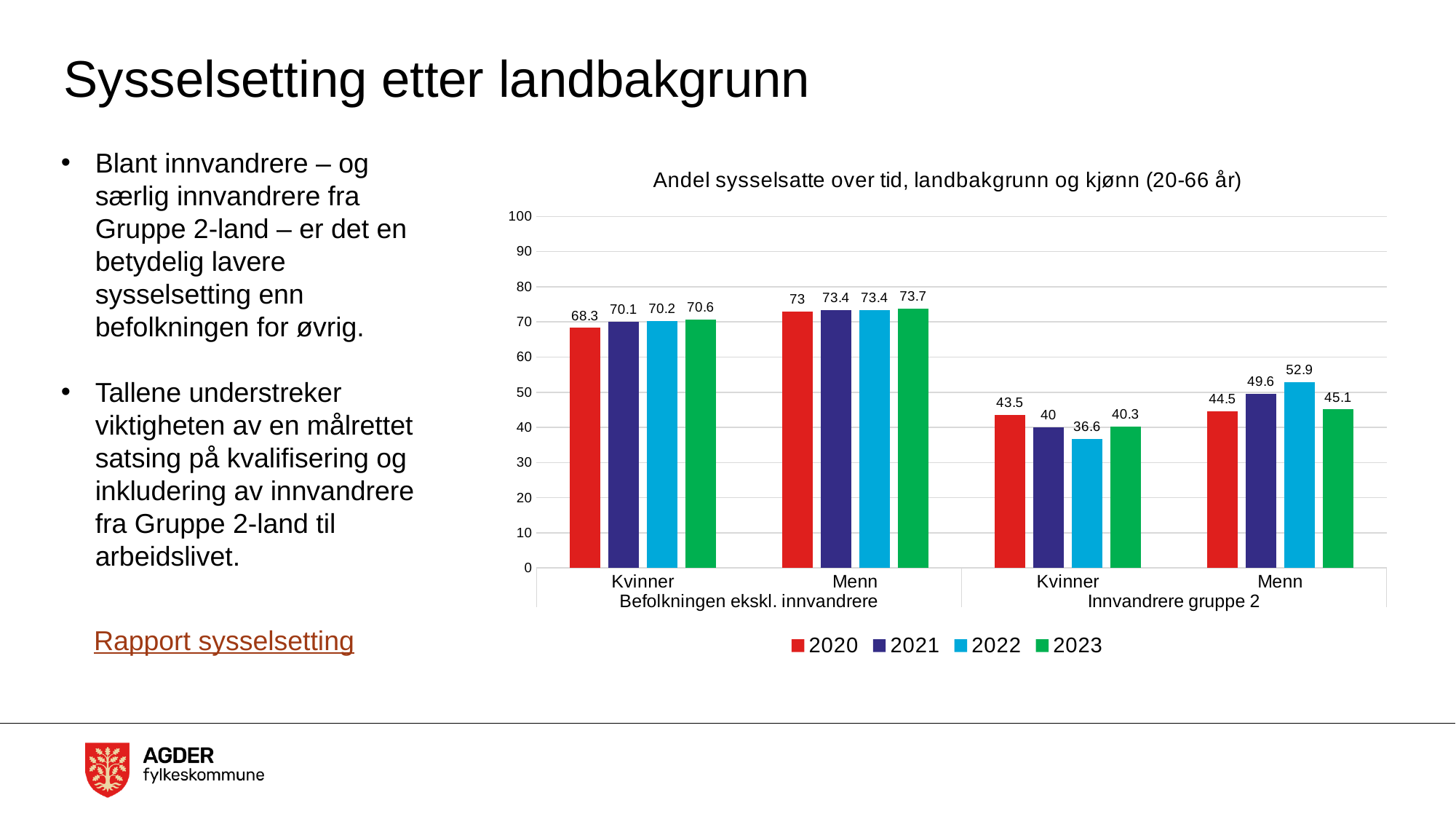
What is the value for Menn in Befolkningen ekskl. innvandrere for 2023? 73.7 What is the value for Kvinner in Innvandrere gruppe 2 for 2021? 40 Which year has the highest value for Menn in Innvandrere gruppe 2? 2022 What is the value for Kvinner in Befolkningen ekskl. innvandrere for 2020? 68.3 How many series does the legend list? 4 What kind of chart is shown on the slide? Bar chart What is the value for Menn in Innvandrere gruppe 2 for 2022? 52.9 What is the difference between the 2023 values for Menn in Befolkningen ekskl. innvandrere and Menn in Innvandrere gruppe 2? 28.6 Which is larger: the 2020 value for Kvinner in Innvandrere gruppe 2 or the 2020 value for Menn in Innvandrere gruppe 2? Menn in Innvandrere gruppe 2 What is the title of the chart? Andel sysselsatte over tid, landbakgrunn og kjønn (20-66 år) Which year has the lowest value for Kvinner in Innvandrere gruppe 2? 2022 Do the values for Kvinner in Befolkningen ekskl. innvandrere rise or fall from 2020 to 2023? Rise